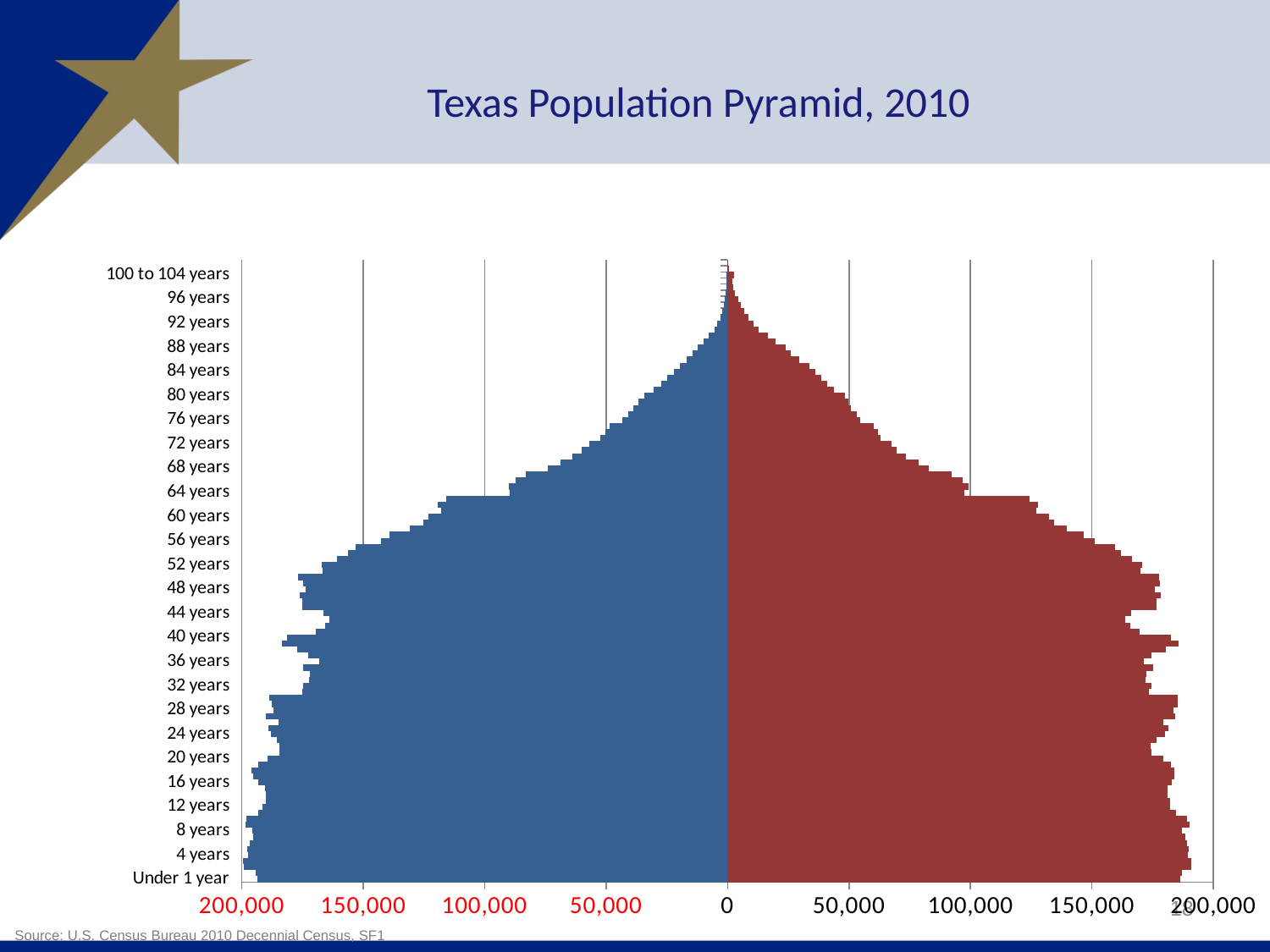
Is the value of the red bar for 40 years greater or less than 150,000? greater Is the value of the blue bar for 80 years greater or less than 50,000? less Is the value of the blue bar for 68 years greater or less than 50,000? greater Do the bar lengths generally rise or fall as age increases from Under 1 year to 100 to 104 years? fall How many data series (colours) are plotted in the chart? 2 What kind of chart is shown on the slide? bar chart What is the title of the chart? Texas Population Pyramid, 2010 What is the largest value shown on the horizontal axis? 200,000